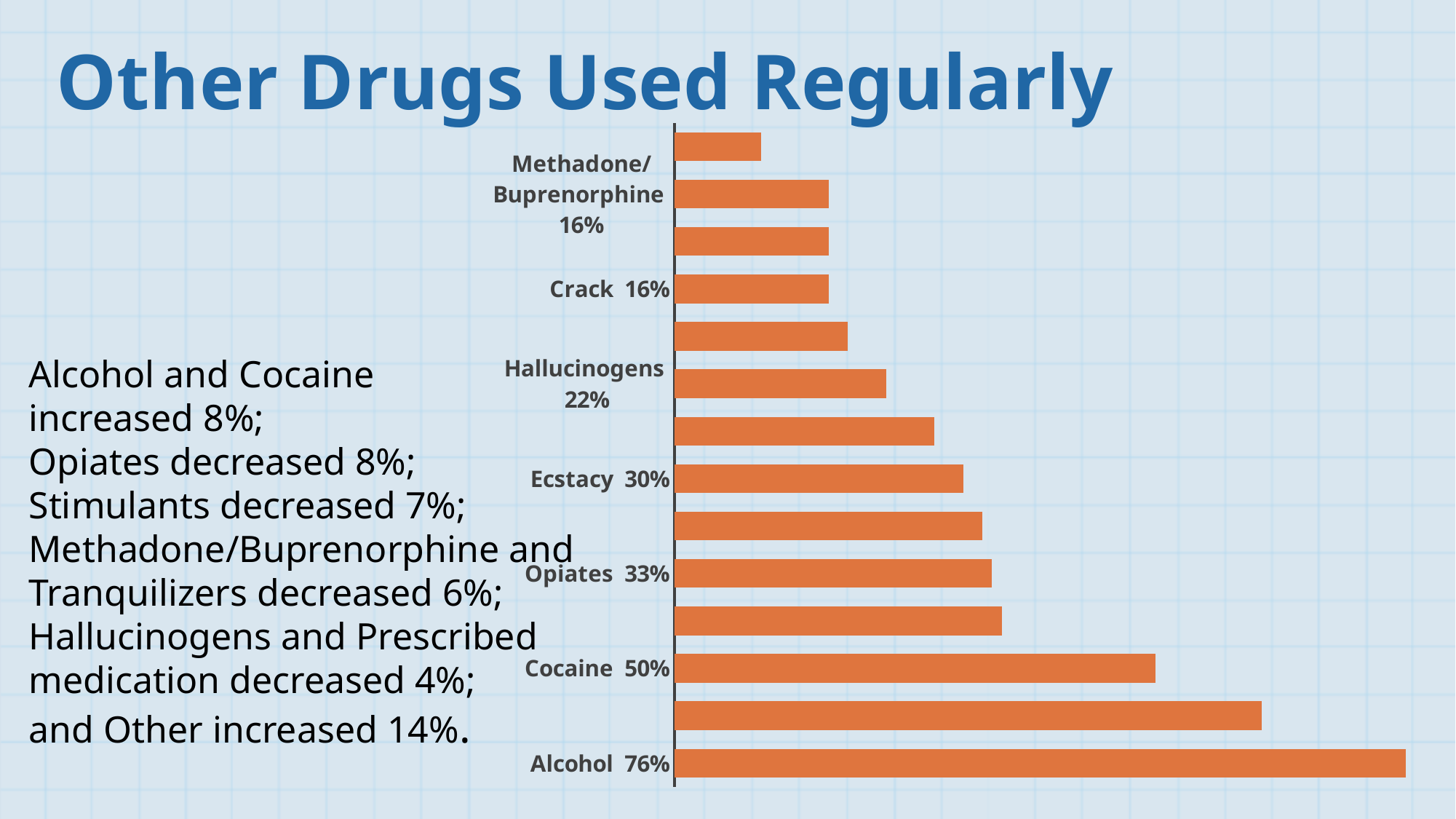
Which has a larger value, Opiates or Ecstacy? Opiates What is the value shown for Ecstacy? 30% What is the value shown for Cocaine? 50% What is the value shown for Crack? 16% What is the value shown for Alcohol? 76% What is the title of the slide containing the chart? Other Drugs Used Regularly What is the difference between the values for Hallucinogens and Crack? 6% What is the difference between the values for Alcohol and Cocaine? 26% What is the value shown for Hallucinogens? 22% Which labeled drug has the highest value in the chart? Alcohol What kind of chart is shown on the slide? bar chart What is the value shown for Opiates? 33%